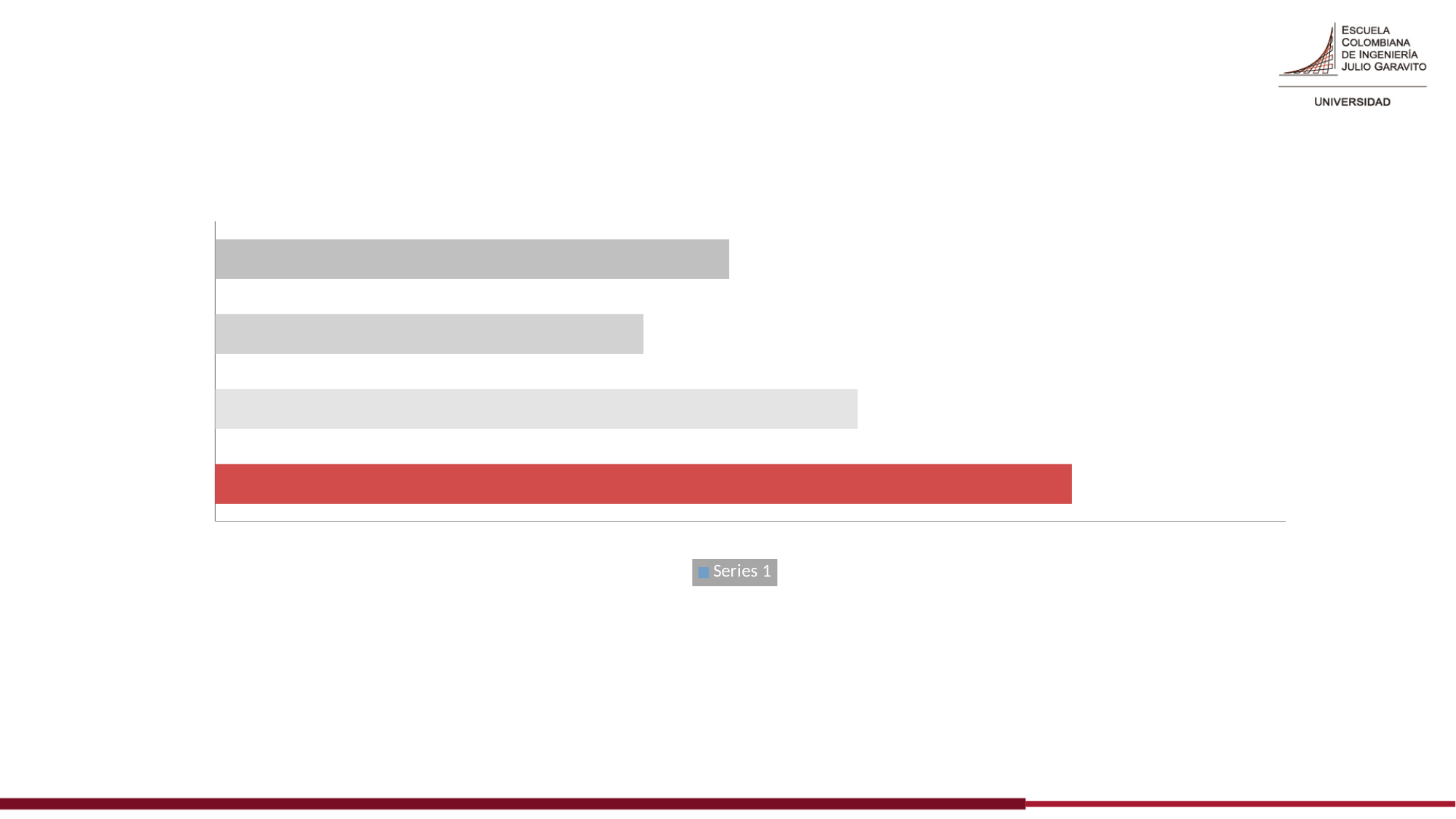
How many bars does the chart show? 4 What colour is the longest bar in the chart? red Are the bars in the chart horizontal or vertical? horizontal What is the name of the series shown in the legend? Series 1 Which bar is the shortest: the top, second, third, or bottom bar? second bar How many series does the legend list? 1 Which bar is the longest: the top, second, third, or bottom bar? bottom bar Which is longer, the second bar from the top or the third bar from the top? third bar Which is longer, the top bar or the bottom bar? bottom bar What kind of chart is shown on the slide? bar chart